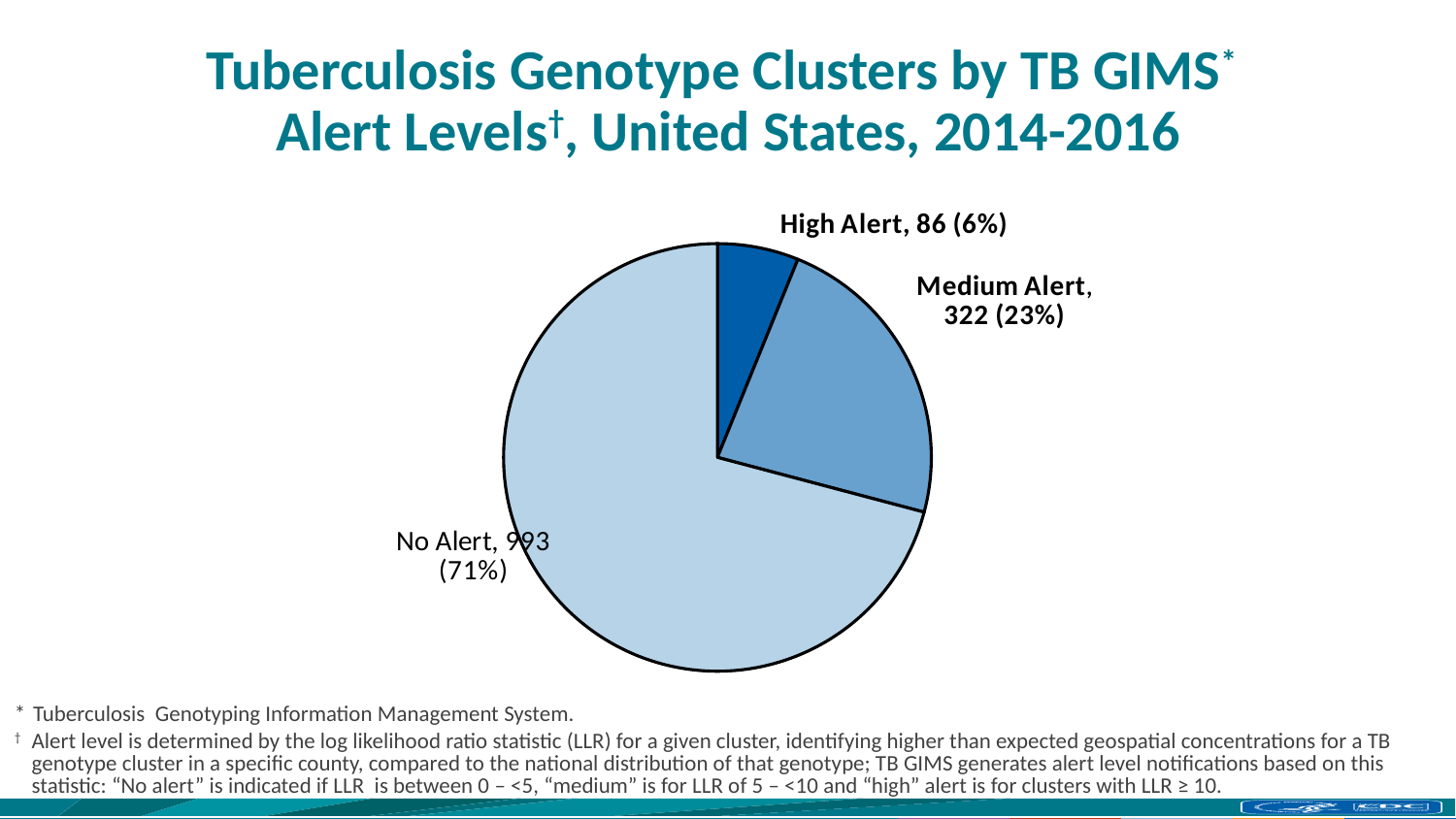
Which alert level has the smallest number of clusters? High Alert What type of chart is shown on the slide? Pie chart How many genotype clusters are in the Medium Alert category? 322 Which has more clusters, Medium Alert or High Alert? Medium Alert How many genotype clusters are in the No Alert category? 993 What is the difference in the number of clusters between Medium Alert and High Alert? 236 What share of the pie does the No Alert slice represent? 71% How many genotype clusters are in the High Alert category? 86 What years does the chart title say the data cover? 2014-2016 What share of the pie does the Medium Alert slice represent? 23% Which alert level has the largest number of clusters? No Alert How many alert-level categories does the pie chart show? 3